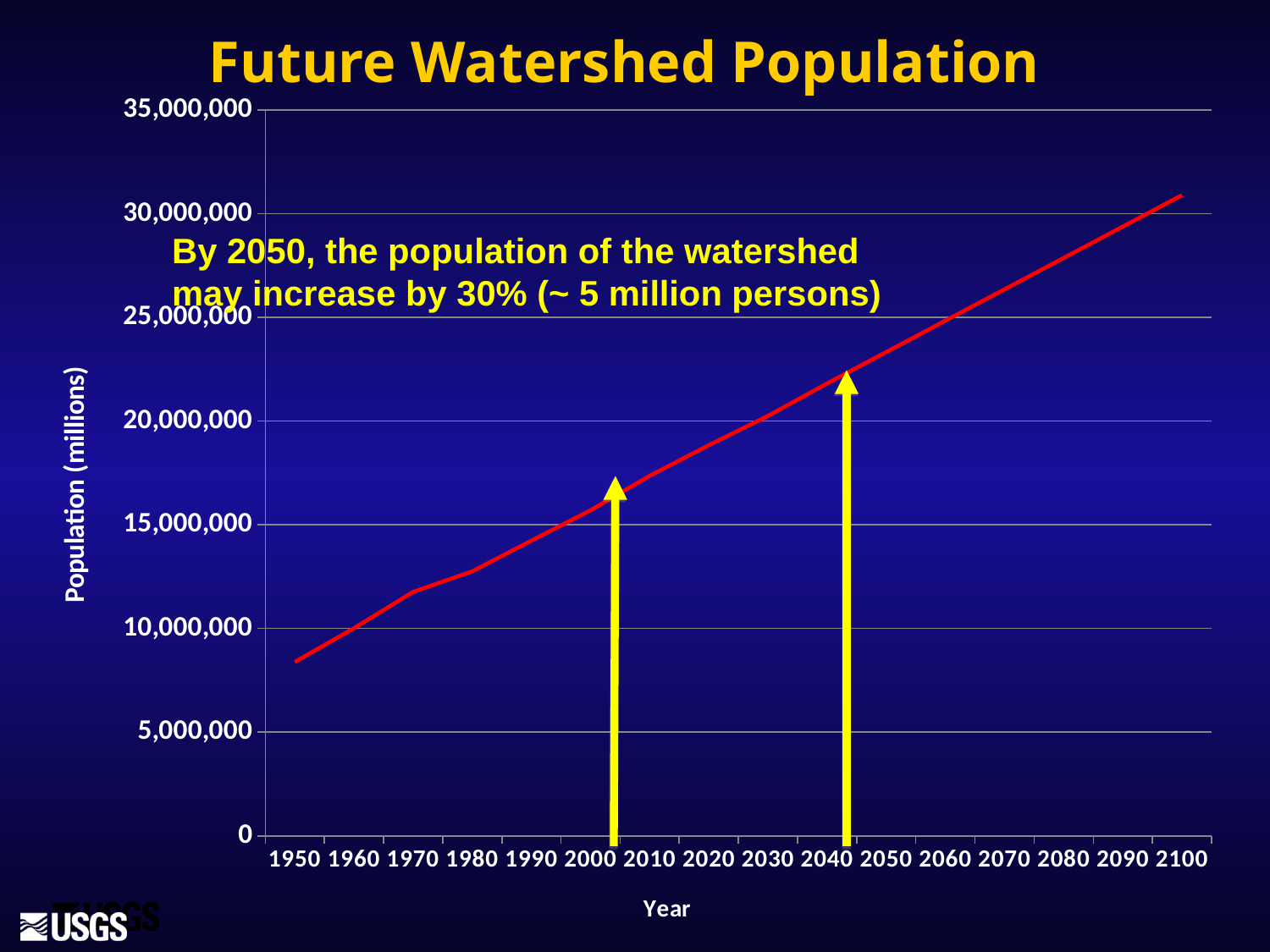
What kind of chart is shown on the slide? line chart Do the population values rise or fall as the year increases along the x axis? rise Is the population value for 2050 greater or less than 20,000,000? greater What is the label of the y axis? Population (millions) Is the population value for 2000 greater or less than 15,000,000? greater Is the population value for 1980 greater or less than 15,000,000? less In which year shown on the x axis is the population lowest? 1950 What is the title of the chart? Future Watershed Population In which year shown on the x axis is the population highest? 2100 Which year has the larger population value, 1970 or 2030? 2030